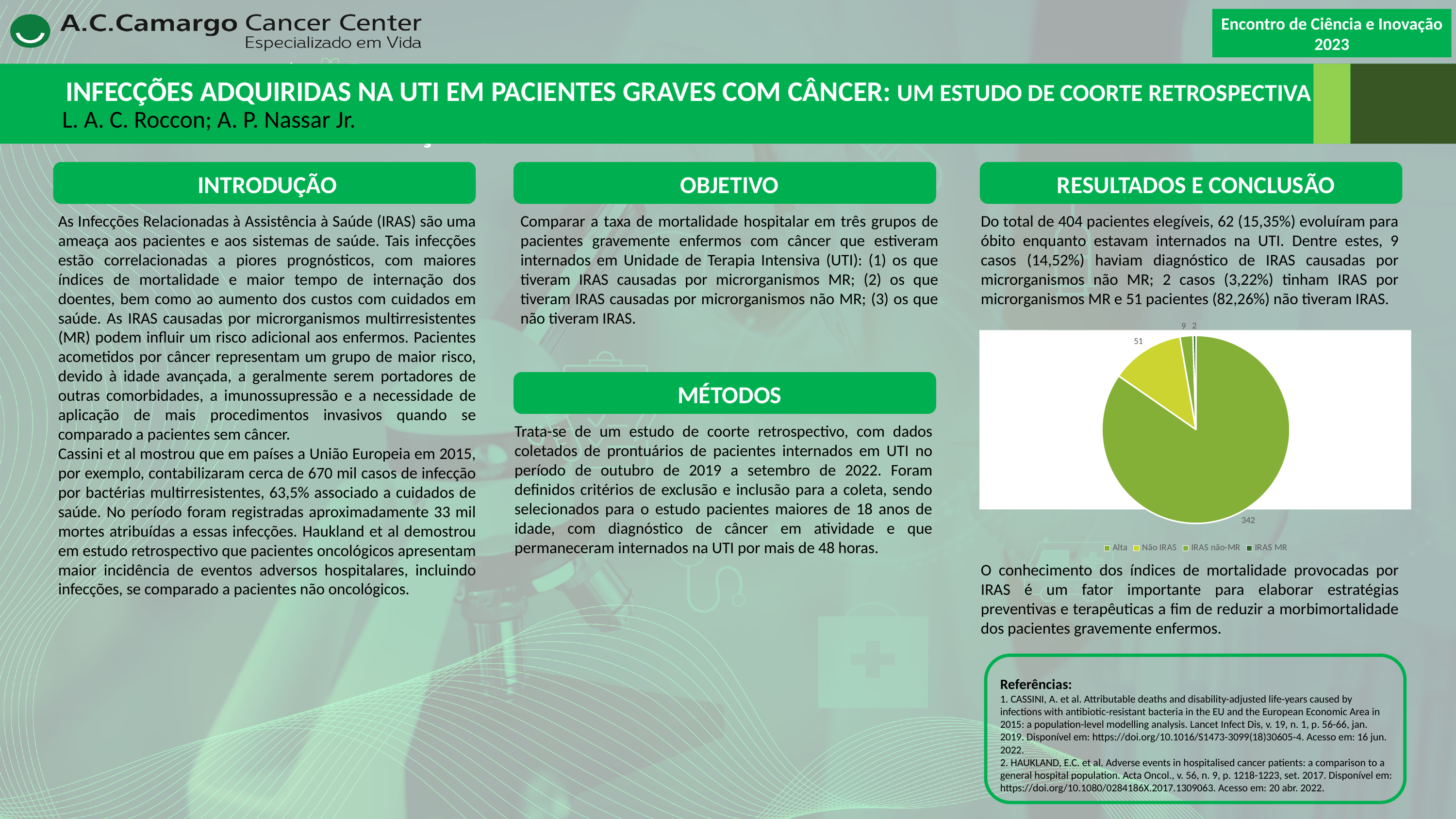
What is the value of the IRAS não-MR slice in the pie chart? 9 Which is larger in the pie chart, Não IRAS or IRAS não-MR? Não IRAS How many entries does the legend of the pie chart list? 4 Which category has the smallest slice in the pie chart? IRAS MR What is the total of all slices in the pie chart? 404 What is the value of the Alta slice in the pie chart? 342 How many slices does the pie chart have? 4 What is the value of the IRAS MR slice in the pie chart? 2 What is the difference between the Alta and Não IRAS values in the pie chart? 291 Which category has the largest slice in the pie chart? Alta What kind of chart is shown on the slide? pie chart What is the value of the Não IRAS slice in the pie chart? 51